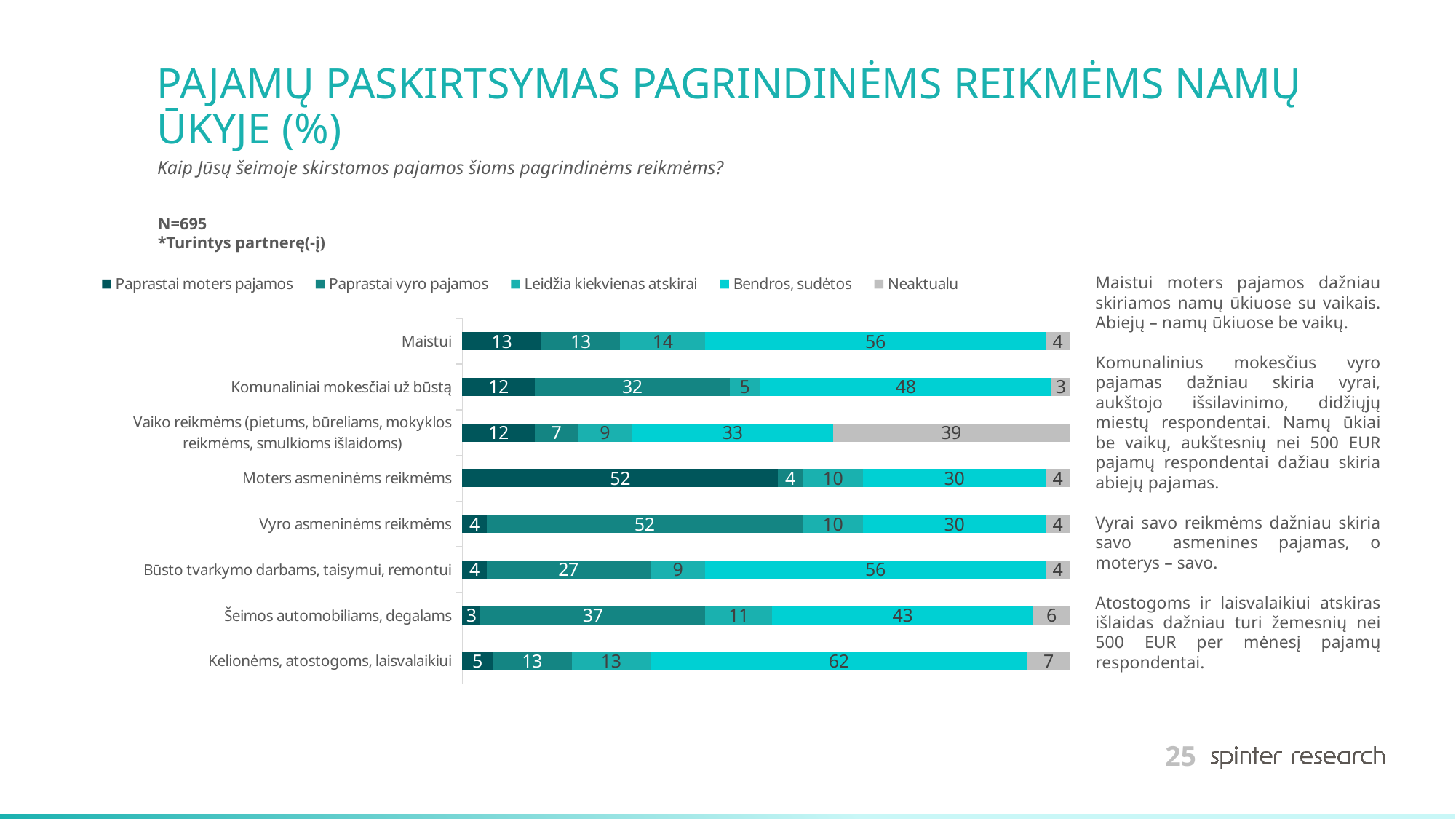
Which legend entry is shown in grey? Neaktualu What is the value of "Bendros, sudėtos" for "Maistui"? 56 Which category has the highest value for "Bendros, sudėtos"? Kelionėms, atostogoms, laisvalaikiui What is the value of "Paprastai vyro pajamos" for "Komunaliniai mokesčiai už būstą"? 32 How many categories are plotted in the chart? 8 What is the value of "Neaktualu" for "Vaiko reikmėms (pietums, būreliams, mokyklos reikmėms, smulkioms išlaidoms)"? 39 Which is larger: the "Bendros, sudėtos" value for "Šeimos automobiliams, degalams" or for "Būsto tvarkymo darbams, taisymui, remontui"? Būsto tvarkymo darbams, taisymui, remontui How many series does the legend list? 5 Which category has the lowest value for "Paprastai moters pajamos"? Šeimos automobiliams, degalams What kind of chart is shown on the slide? Stacked bar chart What is the total of the stacked bar for "Kelionėms, atostogoms, laisvalaikiui"? 100 What is the difference between the "Paprastai moters pajamos" value for "Moters asmeninėms reikmėms" and for "Vyro asmeninėms reikmėms"? 48